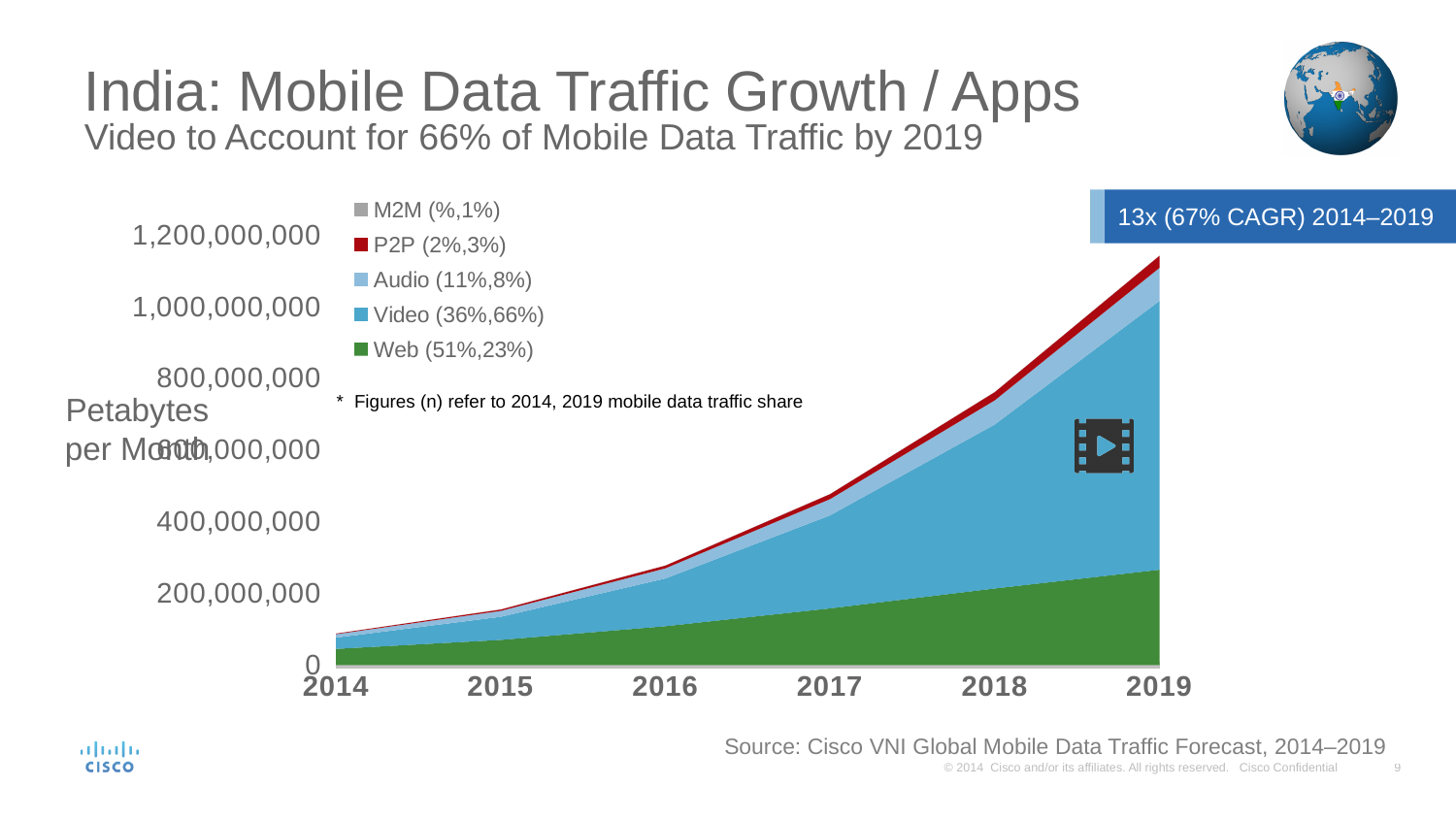
What unit is used on the y axis of the chart? Petabytes per Month According to the legend, which application category has the largest share of mobile data traffic in 2019? Video Is the total mobile data traffic for 2018 greater or less than 400,000,000 petabytes per month? greater Does total mobile data traffic rise or fall from 2014 to 2019 in the chart? Rises What growth multiple and CAGR for 2014–2019 are stated on the chart? 13x (67% CAGR) Is the total mobile data traffic for 2019 greater or less than 1,000,000,000 petabytes per month? greater How many years are shown along the x axis of the chart? 6 According to the legend, what share of mobile data traffic did Web account for in 2014? 51% Is the total mobile data traffic for 2014 greater or less than 200,000,000 petabytes per month? less How many series does the chart legend list? 5 According to the legend, what share of mobile data traffic does Video account for in 2019? 66% What kind of chart is shown on the slide? Stacked area chart